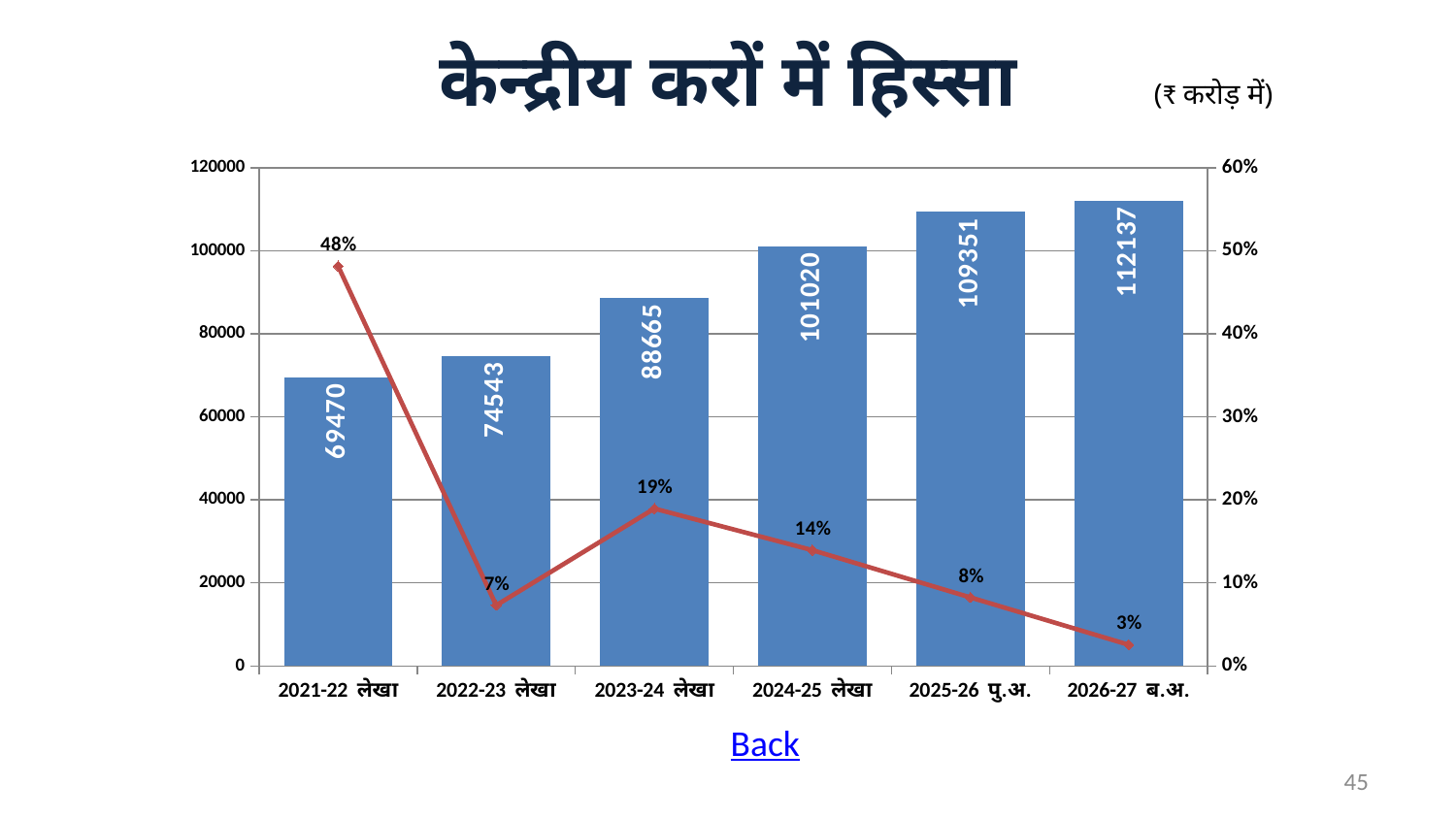
What is the bar value for 2023-24 लेखा? 88665 What is the difference between the bar values for 2024-25 लेखा and 2023-24 लेखा? 12355 What is the bar value for 2026-27 ब.अ.? 112137 What percentage does the line show for 2025-26 पु.अ.? 8% Which is larger, the bar value for 2022-23 लेखा or for 2021-22 लेखा? 2022-23 लेखा How many categories are shown on the x axis? 6 Which category has the highest bar value? 2026-27 ब.अ. What unit is stated next to the chart title? ₹ करोड़ में Do the bar values rise or fall from 2021-22 लेखा to 2026-27 ब.अ.? rise What is the title of the chart? केन्द्रीय करों में हिस्सा What percentage does the line show for 2021-22 लेखा? 48% Which category has the lowest percentage on the line? 2026-27 ब.अ.